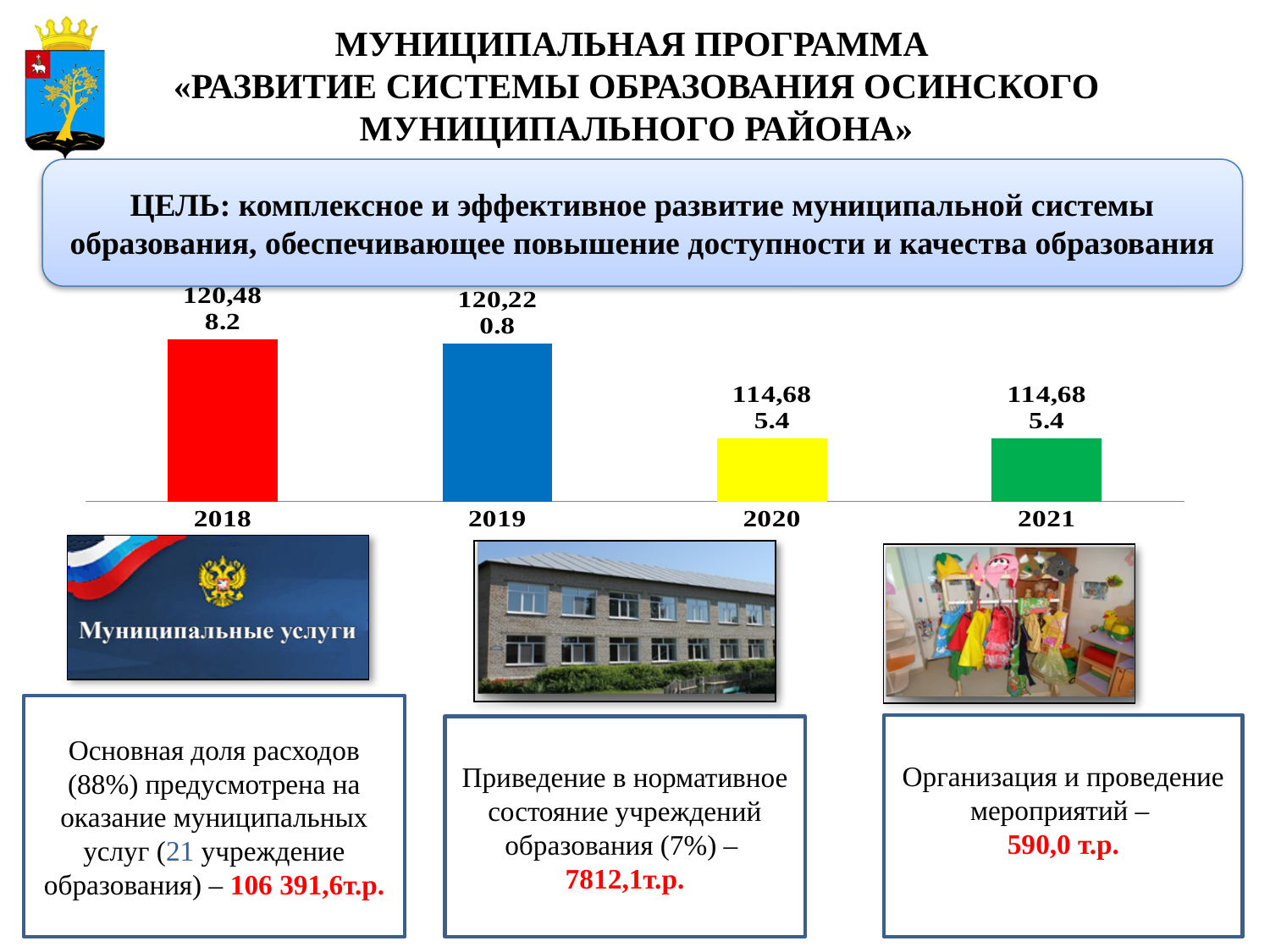
What value is labelled on the bar for 2020? 114,685.4 What value is labelled on the bar for 2018? 120,488.2 What value is labelled on the bar for 2021? 114,685.4 What colour is the bar for 2018? red How many years (categories) are plotted on the chart? 4 What kind of chart is shown on the slide? bar chart Do the bar values rise or fall from 2018 to 2021? fall Which year has the highest bar on the chart? 2018 Which is larger, the value for 2019 or the value for 2020? 2019 What value is labelled on the bar for 2019? 120,220.8 What colour is the bar for 2020? yellow Which is larger, the value for 2018 or the value for 2021? 2018